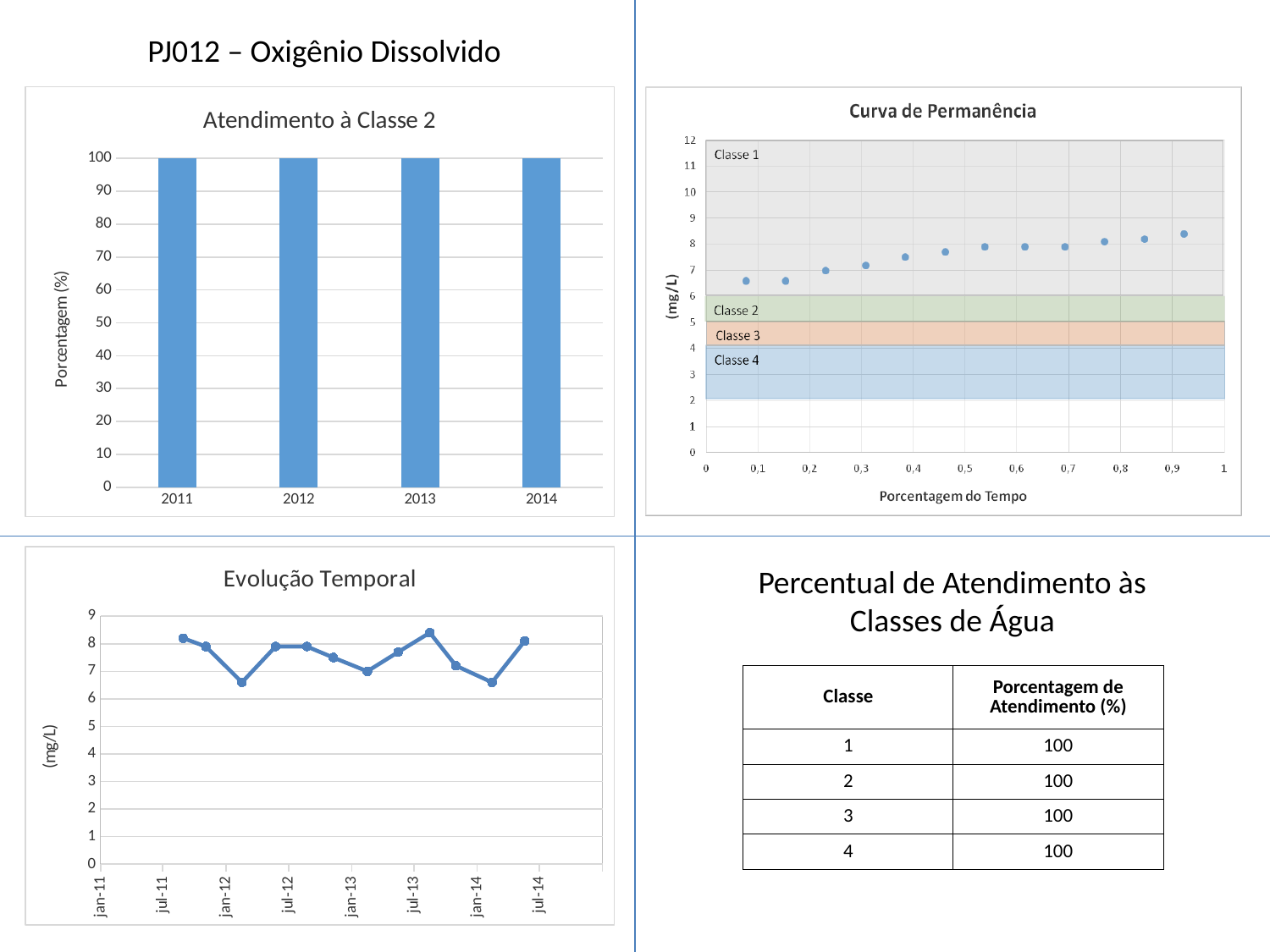
On the 'Atendimento à Classe 2' chart, what is the value for 2014? 100 On the 'Atendimento à Classe 2' chart, what is the difference between the values for 2012 and 2013? 0 On the 'Curva de Permanência' chart, is the value at 0,9 on the x axis greater or less than 9? less On the 'Atendimento à Classe 2' chart, what is the value for 2011? 100 On the 'Curva de Permanência' chart, do the values rise or fall as the percentage of time increases? rise On the 'Evolução Temporal' chart, is the value at jan-12 greater or less than 6? greater What kind of chart is 'Evolução Temporal'? line chart How many years are shown on the 'Atendimento à Classe 2' chart? 4 On the 'Curva de Permanência' chart, is the value at 0,1 on the x axis greater or less than 6? greater What kind of chart is 'Atendimento à Classe 2'? bar chart What is the x-axis label of the 'Curva de Permanência' chart? Porcentagem do Tempo What is the y-axis label of the 'Evolução Temporal' chart? (mg/L)